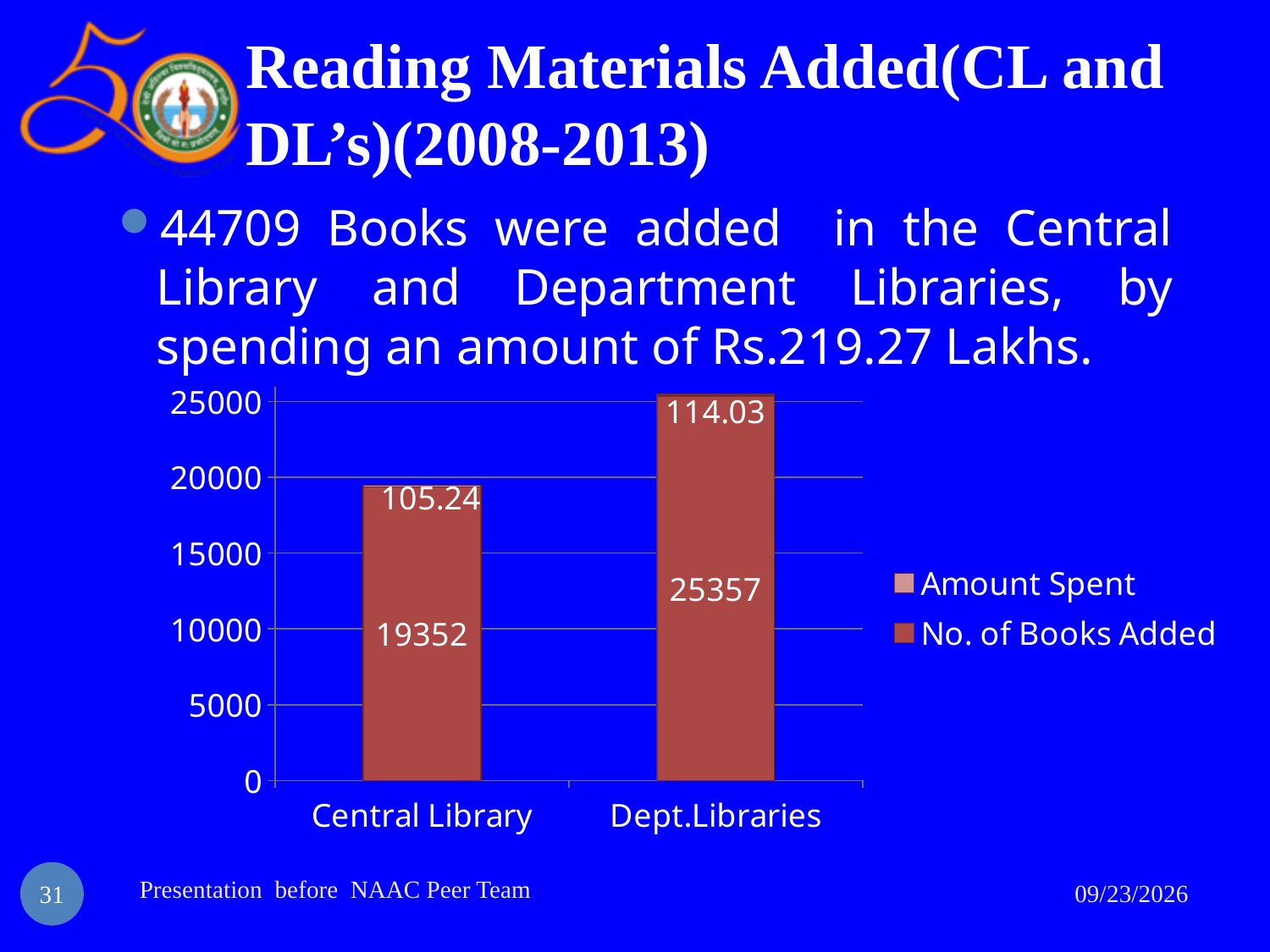
What is the No. of Books Added value for Dept.Libraries? 25357 Is the total height of the Central Library bar greater or less than 15000? greater What is the Amount Spent value shown for Central Library? 105.24 Which has the larger Amount Spent, Central Library or Dept.Libraries? Dept.Libraries What is the Amount Spent value shown for Dept.Libraries? 114.03 How many categories are shown on the x axis of the chart? 2 What is the difference in No. of Books Added between Dept.Libraries and Central Library? 6005 Which category has the higher No. of Books Added? Dept.Libraries What is the difference in Amount Spent between Dept.Libraries and Central Library? 8.79 How many books were added in the Central Library according to the chart? 19352 What type of chart is shown on the slide? bar chart How many series does the chart legend list? 2